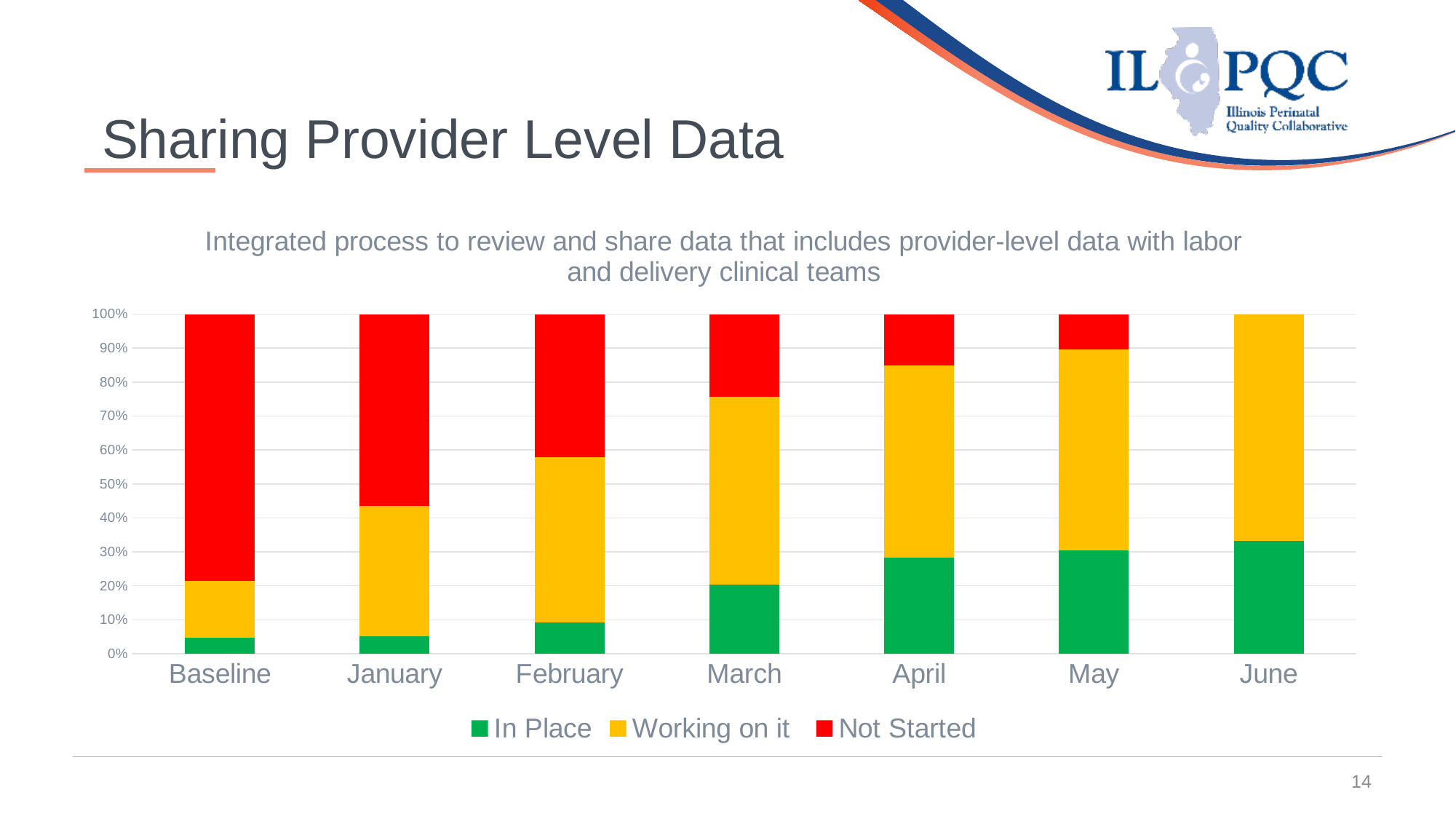
Is the 'In Place' share for June greater or less than 20%? greater Does the 'In Place' share rise or fall from Baseline to June? Rise How many categories are shown along the x axis? 7 What kind of chart is shown on the slide? Stacked bar chart What colour represents the 'Not Started' series in the legend? Red What is the total of the stacked bar for March? 100% Which has a larger 'Not Started' share, January or February? January Which category has the largest 'Not Started' segment? Baseline Which category has the largest 'In Place' segment? June Is the 'Not Started' share for Baseline greater or less than 70%? greater How many series does the legend list? 3 Which category has no 'Not Started' segment at all? June